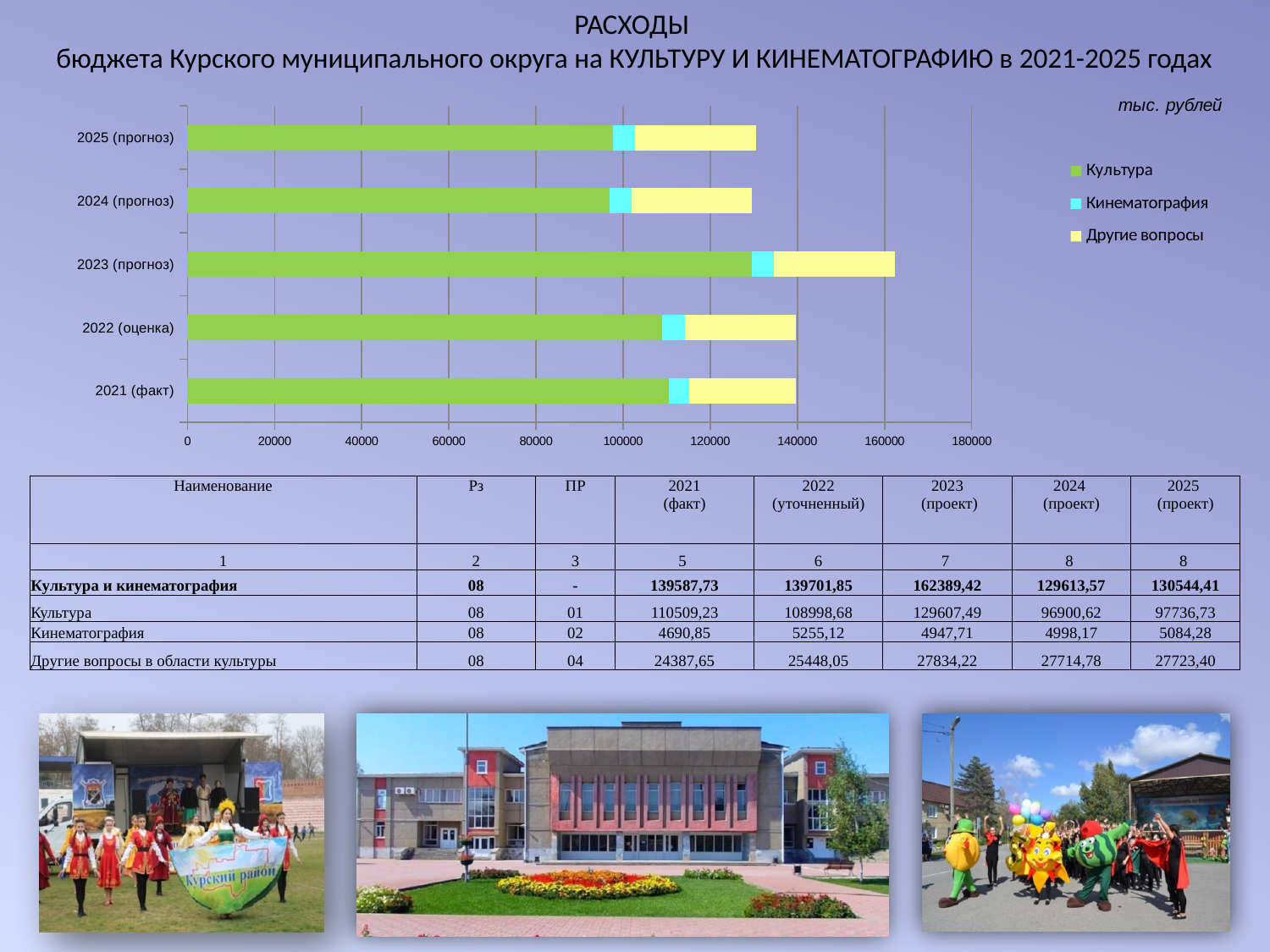
What are the three series named in the chart legend? Культура, Кинематография, Другие вопросы How many years (categories) are plotted in the chart? 5 According to the table, what is the value for Кинематография in 2023? 4947,71 Which year has the highest total bar in the chart? 2023 (прогноз) What kind of chart is shown on the slide? bar chart According to the table, what is the total for Культура и кинематография in 2023? 162389,42 How many series does the chart legend list? 3 Is the total bar for 2023 (прогноз) greater or less than 160000? greater Which is larger, the Культура segment for 2021 (факт) or for 2024 (прогноз)? 2021 (факт) Is the Культура segment for 2025 (прогноз) greater or less than 100000? less Using the table values, what is the difference between the Культура и кинематография totals for 2023 and 2022? 22687,57 According to the table, what is the value for Культура in 2021 (факт)? 110509,23